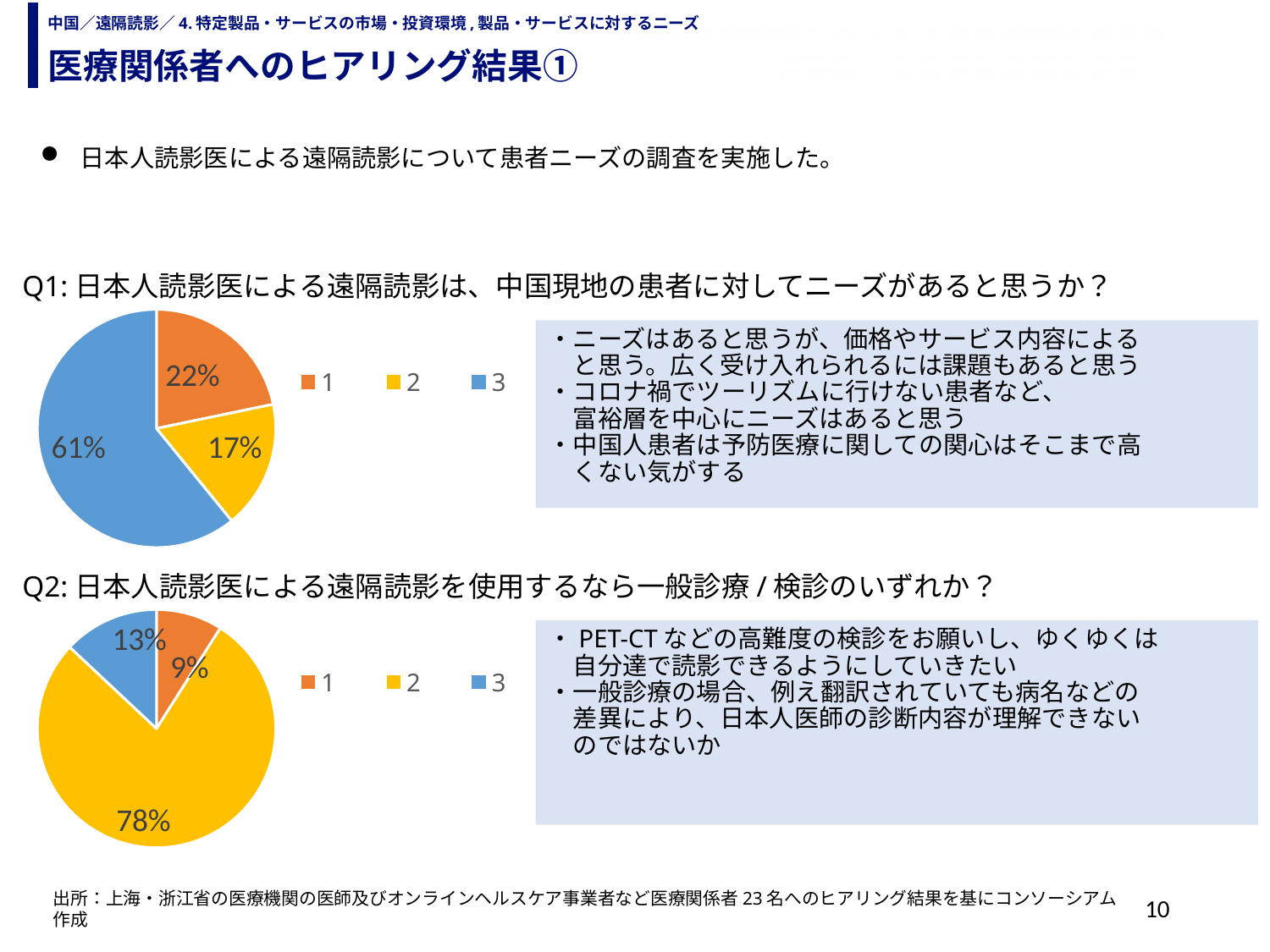
In the Q1 pie chart (top), which category has the largest share? 3 In the Q1 pie chart (top), what share does category 3 have? 61% What type of chart is used for Q1 (top)? Pie chart In the Q1 pie chart (top), which category has the smallest share? 2 In the Q2 pie chart (bottom), what share does category 1 have? 9% In the Q1 pie chart (top), what share does category 2 have? 17% In the Q2 pie chart (bottom), what share does category 2 have? 78% In the Q1 pie chart (top), what share does category 1 have? 22% How many entries does the legend of the Q2 pie chart (bottom) list? 3 In the Q1 pie chart (top), what is the difference between the shares of category 3 and category 1? 39% In the Q2 pie chart (bottom), what share does category 3 have? 13% In the Q2 pie chart (bottom), which is larger, the share of category 1 or category 3? 3